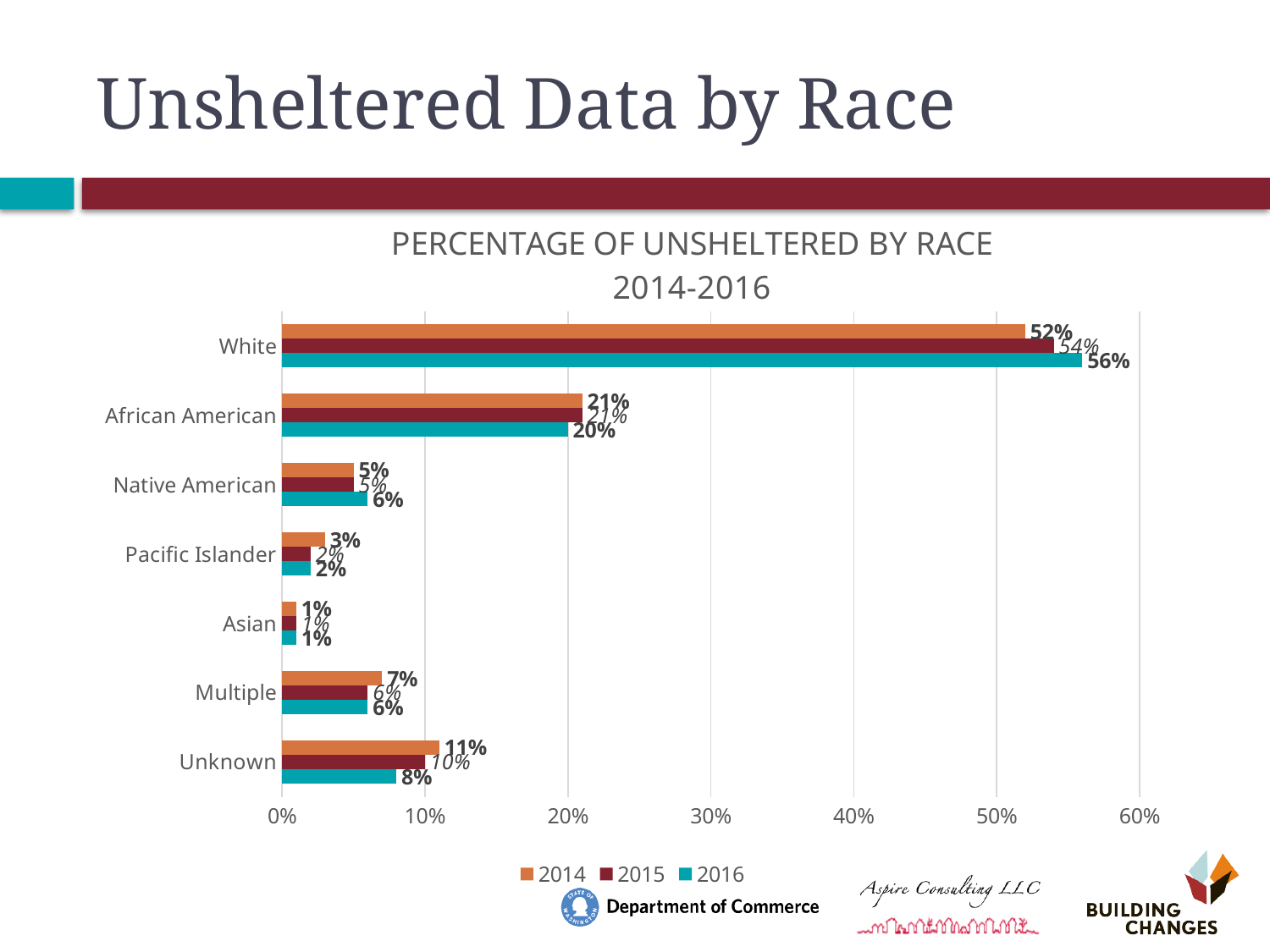
What is the difference between the 2016 and 2014 values for White? 4% What is the 2014 value for African American? 21% Do the values for Unknown rise or fall from 2014 to 2016? Fall What is the 2015 value for Unknown? 10% What type of chart is shown on the slide? Bar chart How many race categories are shown on the chart? 7 How many series does the legend list? 3 Which category has the highest value in 2016? White What is the 2016 value for White? 56% Which is larger, the 2014 value for Unknown or the 2014 value for Multiple? Unknown What is the title of the chart? PERCENTAGE OF UNSHELTERED BY RACE 2014-2016 Which category has the lowest value in 2014? Asian